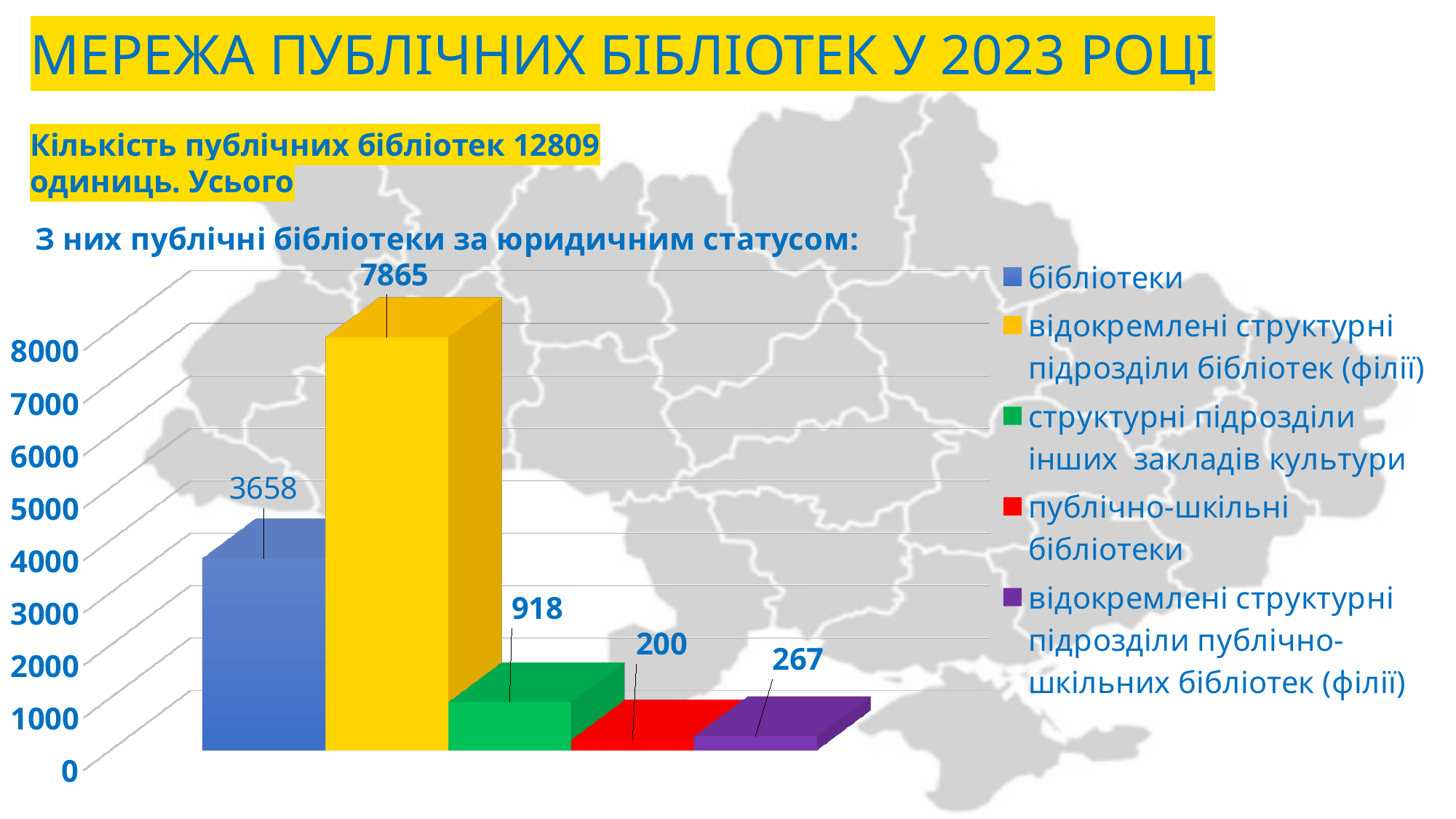
What is the value for відокремлені структурні підрозділи бібліотек (філії)? 7865 How many categories are plotted in the chart? 5 What colour is the bar for публічно-шкільні бібліотеки? red Which is larger: the value for структурні підрозділи інших закладів культури or the value for відокремлені структурні підрозділи публічно-шкільних бібліотек (філії)? структурні підрозділи інших закладів культури What is the value for структурні підрозділи інших закладів культури? 918 What is the value for публічно-шкільні бібліотеки? 200 Which category has the highest value? відокремлені структурні підрозділи бібліотек (філії) What kind of chart is shown on the slide? bar chart What is the value for бібліотеки? 3658 Which category has the lowest value? публічно-шкільні бібліотеки What is the difference between the values for відокремлені структурні підрозділи бібліотек (філії) and бібліотеки? 4207 What is the value for відокремлені структурні підрозділи публічно-шкільних бібліотек (філії)? 267